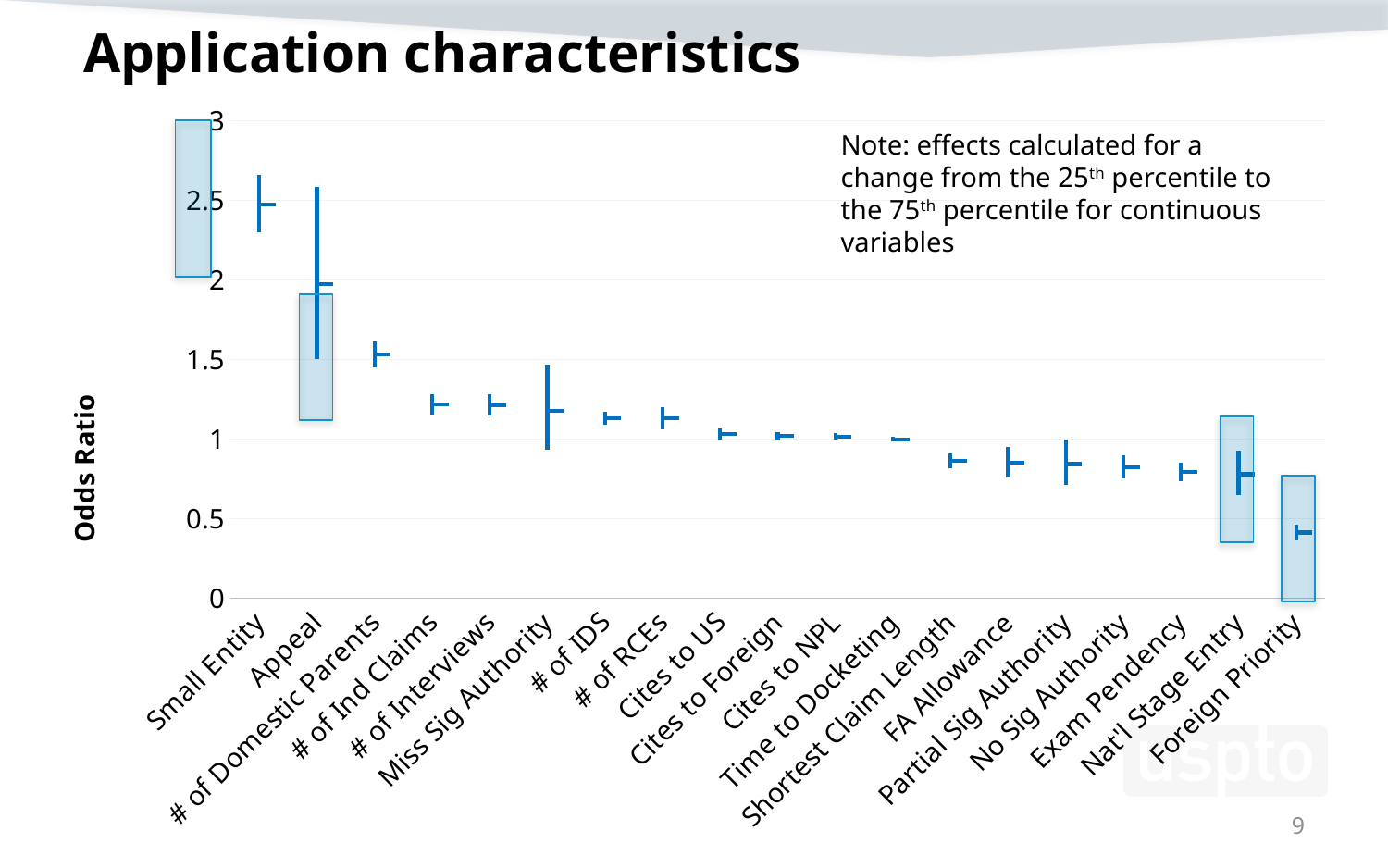
Is the odds ratio point estimate for Foreign Priority greater or less than 0.5? less How many application characteristics are plotted along the x axis of the chart? 19 Which application characteristic has the highest odds ratio point estimate? Small Entity Is the odds ratio point estimate for Appeal greater or less than 1.5? greater Which has the larger odds ratio point estimate, Small Entity or Appeal? Small Entity Which has the larger odds ratio point estimate, # of Ind Claims or Nat'l Stage Entry? # of Ind Claims Is the odds ratio point estimate for Small Entity greater or less than 2? greater Do the odds ratio point estimates generally rise or fall moving from left to right along the x axis? fall Which application characteristic has the lowest odds ratio point estimate? Foreign Priority What is the label of the vertical axis of the chart? Odds Ratio